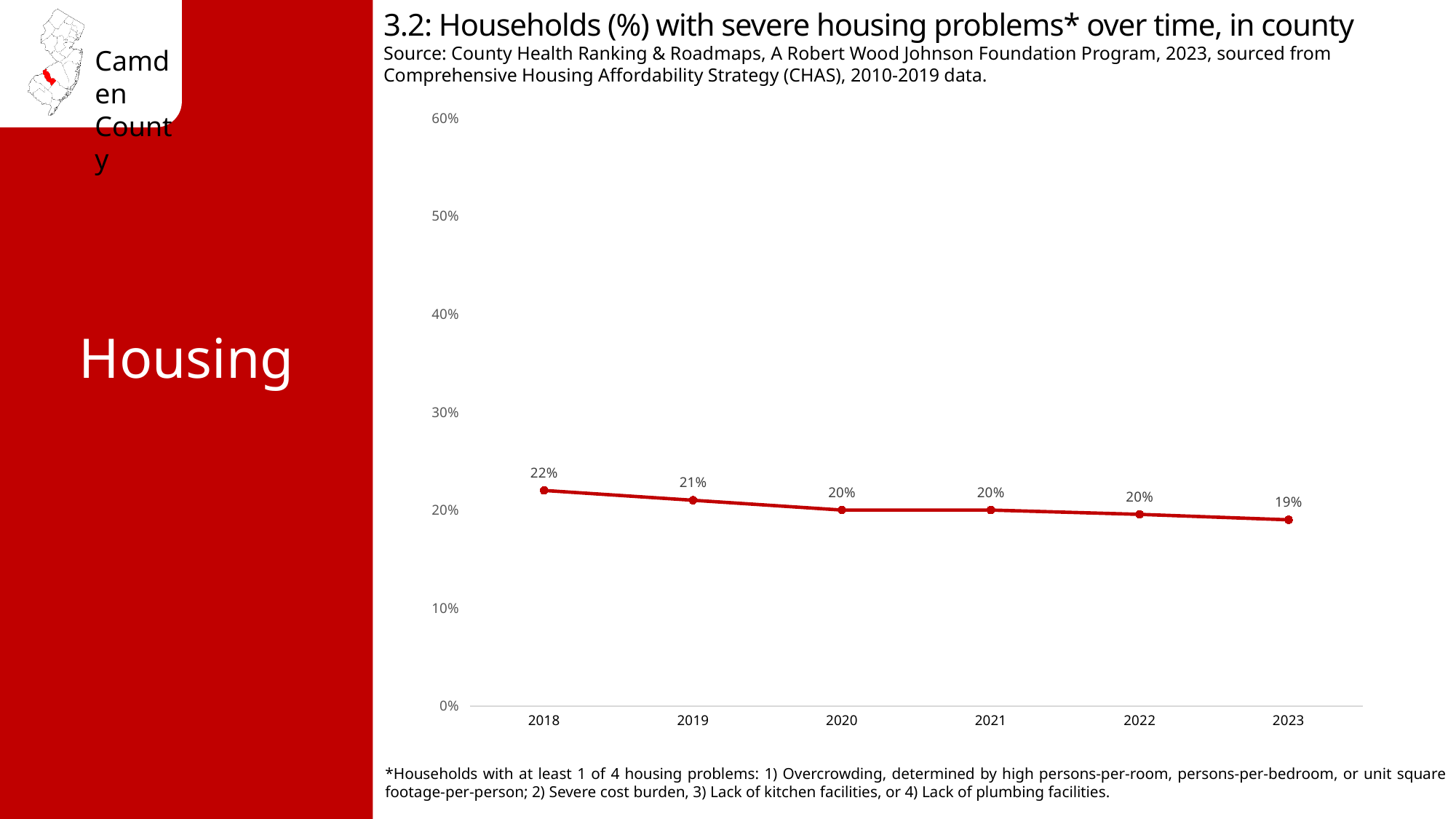
What is the difference between the 2018 value and the 2023 value? 3% What is the title of the chart? 3.2: Households (%) with severe housing problems* over time, in county What is the value shown for 2019? 21% Which year has the lowest percentage of households with severe housing problems? 2023 What kind of chart is shown on the slide? line chart Which year has the highest percentage of households with severe housing problems? 2018 What is the value shown for 2023? 19% Do the values rise or fall from 2018 to 2023? fall Which is larger, the value for 2019 or the value for 2022? 2019 Is the value for 2020 greater or less than 30%? less What percentage of households had severe housing problems in 2018? 22% How many years are plotted on the chart? 6